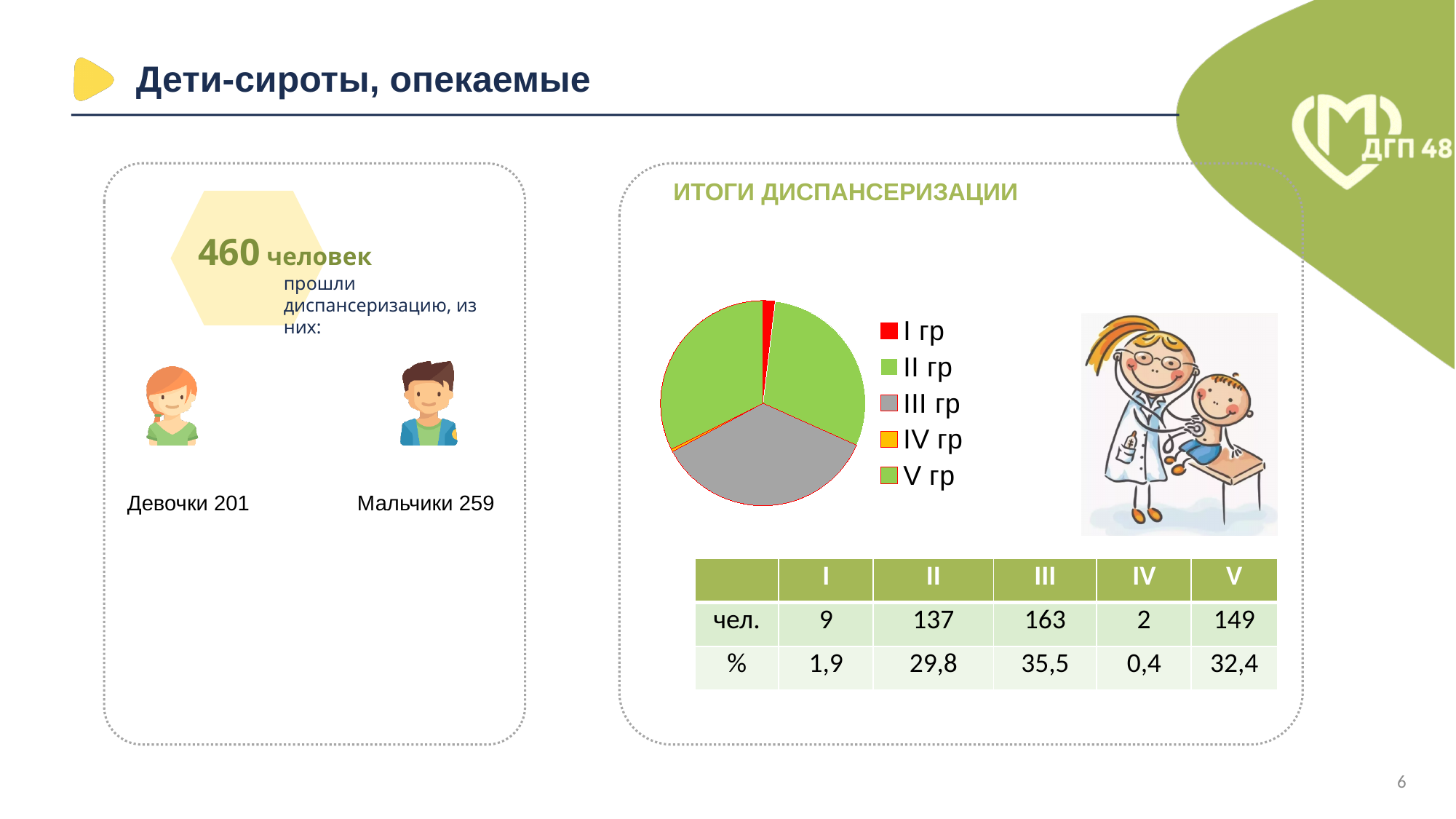
How many health groups does the legend of the pie chart list? 5 Which is larger in the pie chart: group V or group II? V гр Which health group has the smallest share of the pie chart? IV гр According to the table under the pie chart, how many people (чел.) are in group III? 163 Which health group has the largest share of the pie chart? III гр What is the difference in number of people (чел.) between group II and group I in the table? 128 What is the title of the panel containing the pie chart? ИТОГИ ДИСПАНСЕРИЗАЦИИ What kind of chart is shown in the 'ИТОГИ ДИСПАНСЕРИЗАЦИИ' panel? pie chart According to the table under the pie chart, what percentage is group II? 29,8 According to the table under the pie chart, how many people (чел.) are in group IV? 2 What is the difference in number of people (чел.) between group III and group V in the table? 14 What colour is used for group III in the pie chart? grey